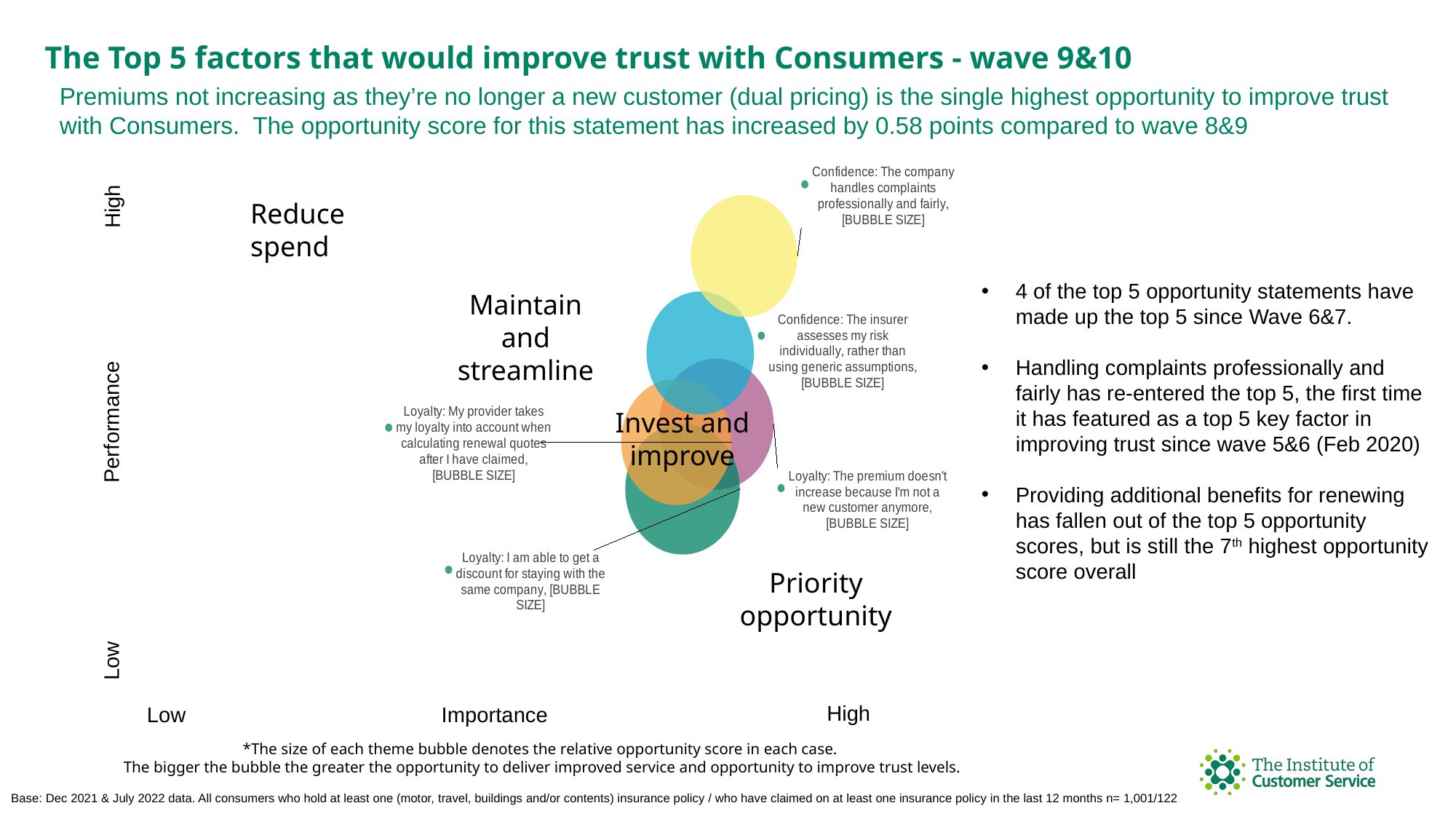
What is the label of the horizontal axis of the chart? Importance What colour is the bubble for 'Confidence: The company handles complaints professionally and fairly'? Yellow What is the label of the vertical axis of the chart? Performance What kind of chart is shown on the slide? Bubble chart Which is positioned higher on the Performance axis: the bubble for 'Confidence: The insurer assesses my risk individually' or the bubble for 'Loyalty: I am able to get a discount for staying with the same company'? Confidence: The insurer assesses my risk individually Which factor's bubble is positioned highest on the Performance axis? Confidence: The company handles complaints professionally and fairly Which factor's bubble is positioned lowest on the Performance axis? Loyalty: I am able to get a discount for staying with the same company How many bubbles (factors) are plotted on the chart? 5